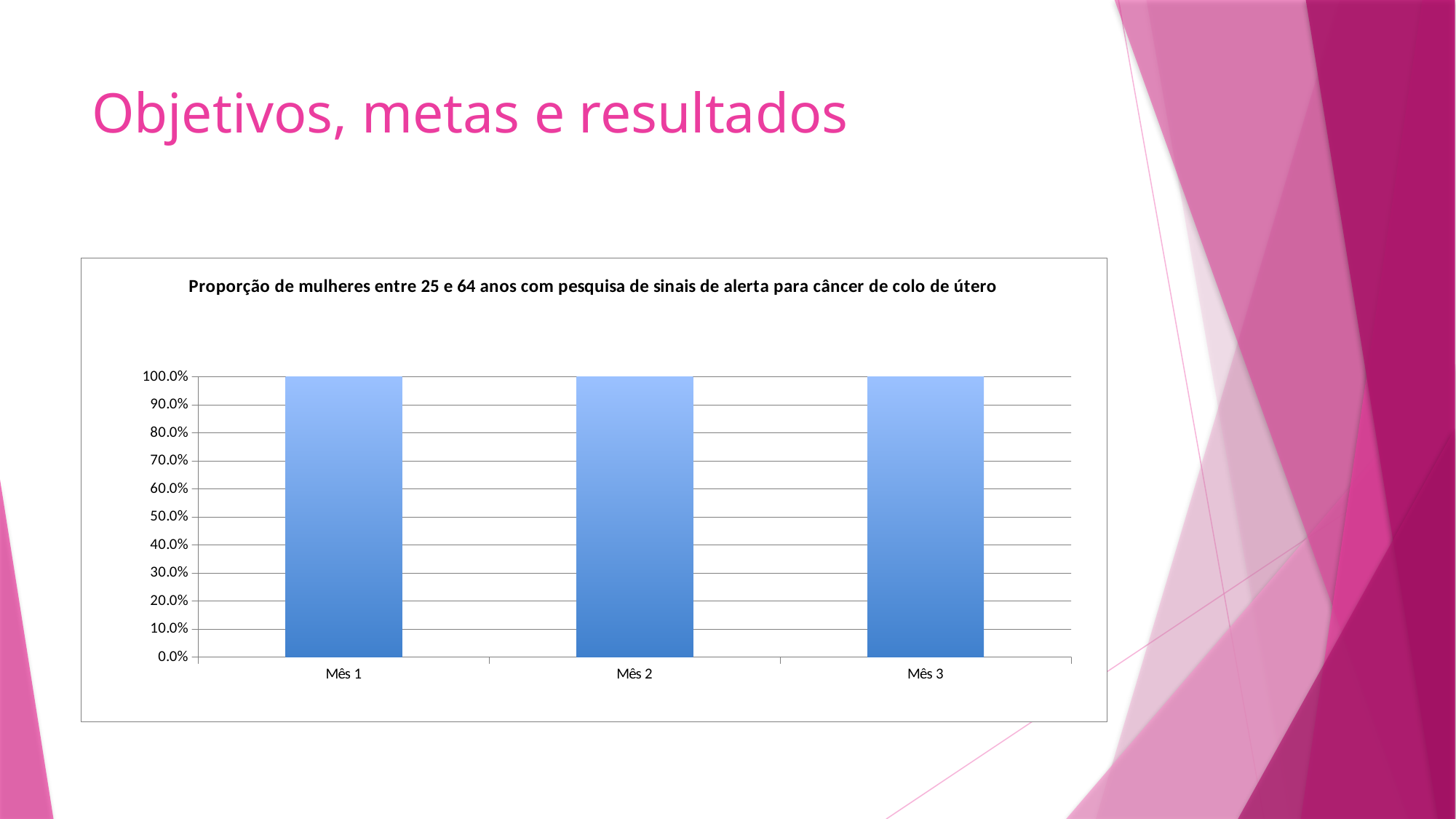
Is the value for Mês 3 greater or less than 90.0%? greater What is the value for Mês 1? 100.0% What is the highest value shown on the y axis of the chart? 100.0% What kind of chart is shown on the slide? bar chart Do the values rise, fall or stay the same from Mês 1 to Mês 3? stay the same How many categories are plotted on the x axis of the chart? 3 What is the difference between the values for Mês 1 and Mês 3? 0.0% What is the title of the chart? Proporção de mulheres entre 25 e 64 anos com pesquisa de sinais de alerta para câncer de colo de útero What is the value for Mês 3? 100.0% Is the value for Mês 2 greater or less than 50.0%? greater What is the value for Mês 2? 100.0%